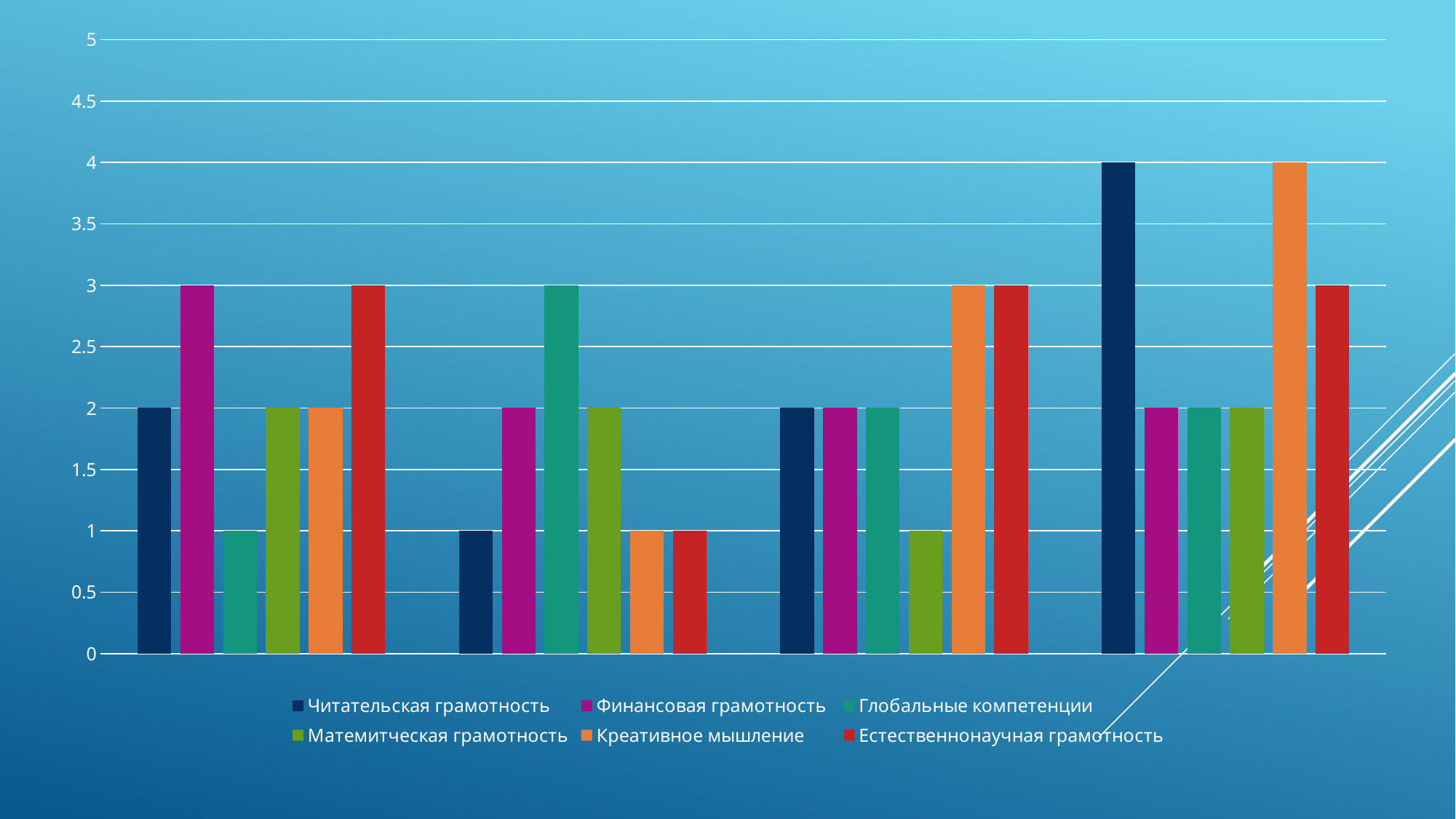
How many series does the legend list? 6 What is the value of Финансовая грамотность in the first (leftmost) group of bars? 3 What kind of chart is shown on the slide? bar chart How many groups of bars are plotted along the x axis? 4 What is the difference between Читательская грамотность in the fourth group and Читательская грамотность in the second group? 3 Which is larger in the first (leftmost) group: Естественнонаучная грамотность or Глобальные компетенции? Естественнонаучная грамотность What is the value of Читательская грамотность in the fourth (rightmost) group of bars? 4 In the fourth (rightmost) group of bars, which series has the lowest value? Финансовая грамотность, Глобальные компетенции and Матемитческая грамотность (all 2) In the second group of bars, which series has the highest value? Глобальные компетенции What is the value of Креативное мышление in the third group of bars? 3 Which series is shown in orange in the legend? Креативное мышление What is the value of Глобальные компетенции in the second group of bars? 3